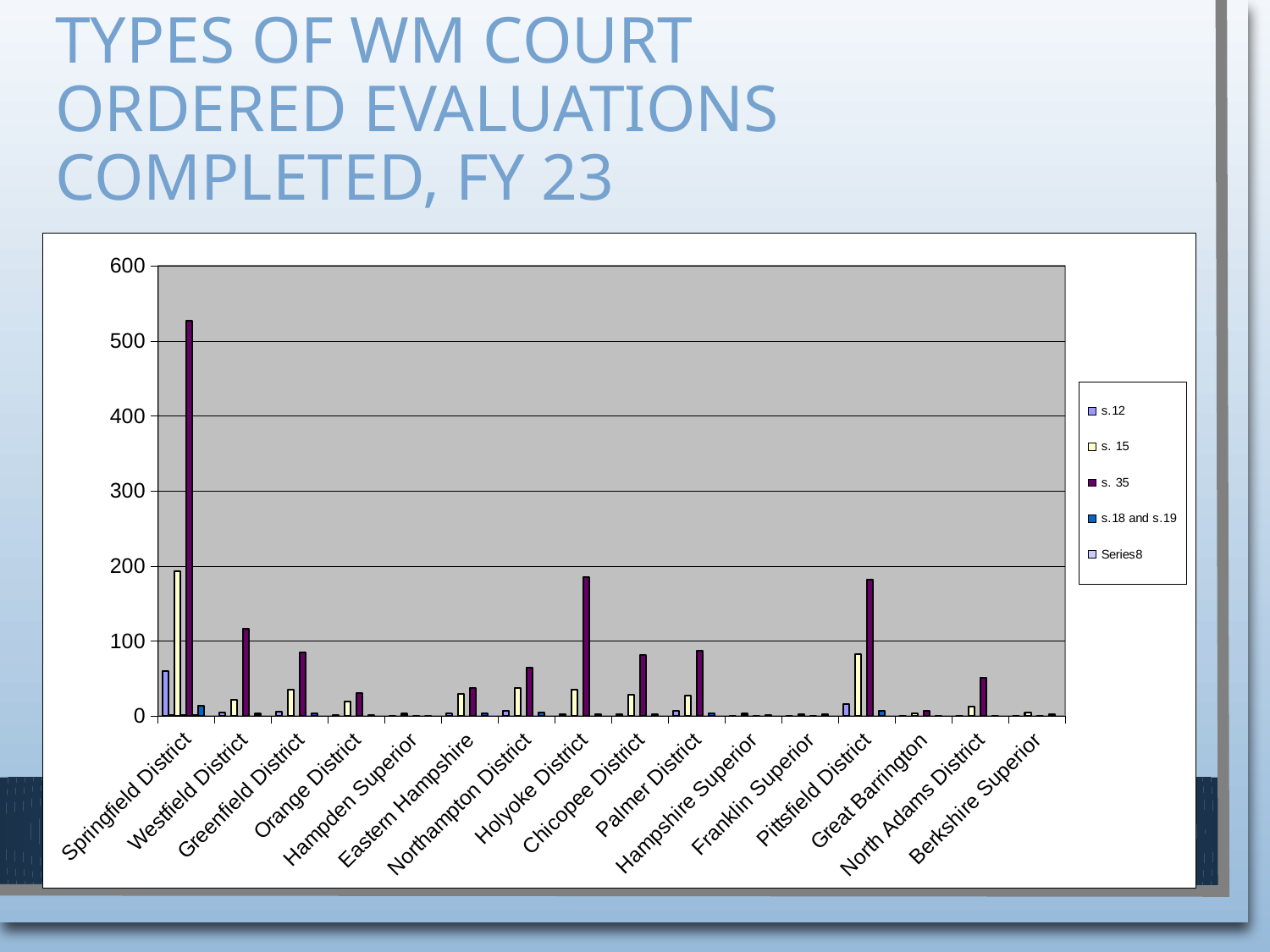
What is the highest value shown on the y axis? 600 Is the s. 35 value for Orange District greater or less than 100? less Which court has the highest s. 35 value? Springfield District How many series does the legend list? 5 Is the s. 35 value for Holyoke District greater or less than 100? greater What kind of chart is shown on the slide? bar chart How many court categories are shown along the x axis? 16 Which is larger, the s. 35 value for Holyoke District or the s. 35 value for Westfield District? Holyoke District Which is larger, the s. 15 value for Springfield District or the s. 15 value for Pittsfield District? Springfield District What is the title of the slide containing the chart? TYPES OF WM COURT ORDERED EVALUATIONS COMPLETED, FY 23 Is the s. 35 value for Springfield District greater or less than 500? greater